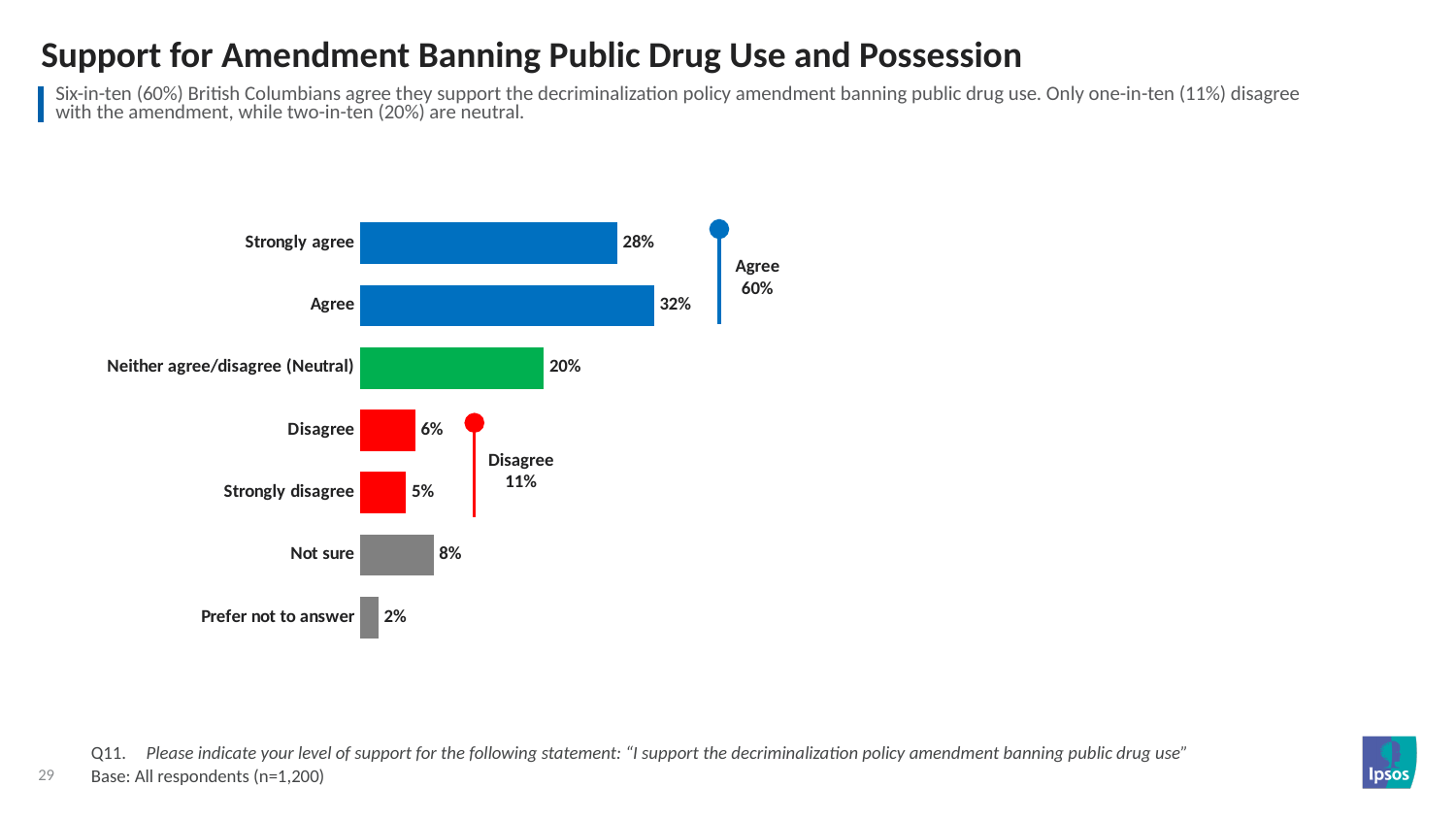
What percentage of respondents selected "Strongly agree"? 28% What percentage of respondents selected "Neither agree/disagree (Neutral)"? 20% What type of chart is shown on the slide? Bar chart Which is larger, the percentage for "Disagree" or for "Strongly disagree"? Disagree How many response categories are shown in the chart? 7 What is the combined percentage for "Disagree" and "Strongly disagree"? 11% What is the difference in percentage points between "Agree" and "Strongly agree"? 4 What combined percentage is shown for the "Agree" bracket in the chart? 60% Which response category has the highest percentage? Agree Which response category has the lowest percentage? Prefer not to answer What percentage of respondents selected "Agree"? 32% What percentage of respondents selected "Prefer not to answer"? 2%